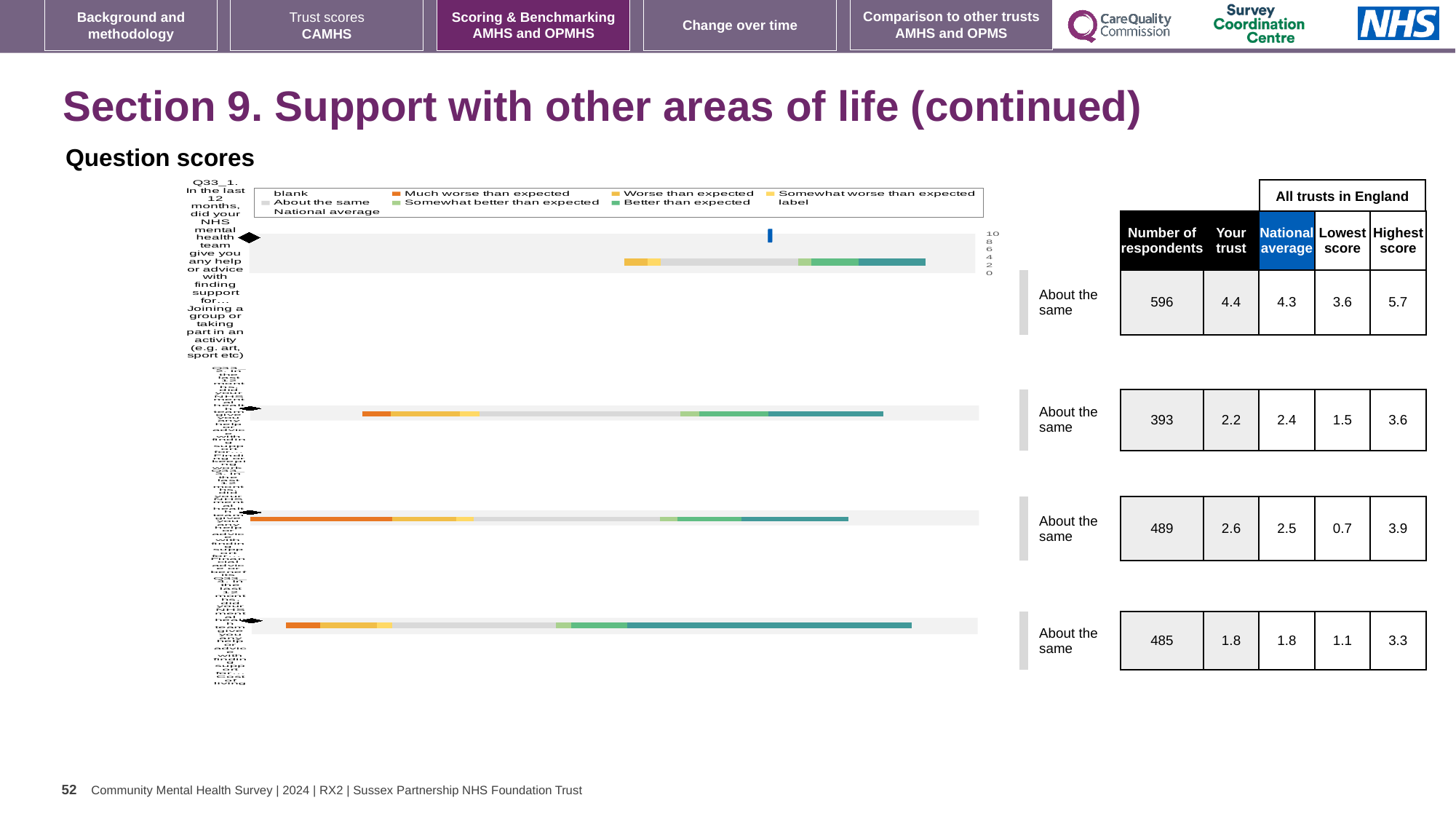
How many entries does the chart legend list? 9 How many of the four bars are labelled 'About the same'? 4 What is the benchmark category shown next to the first bar (Q33_1, joining a group or taking part in an activity)? About the same Which legend entry is shown in orange in the chart? Much worse than expected How many horizontal bars are plotted in the chart? 4 Which legend entry is shown in light grey in the chart? About the same What kind of chart is shown under 'Question scores'? Bar chart What is the highest value shown on the chart's axis? 10